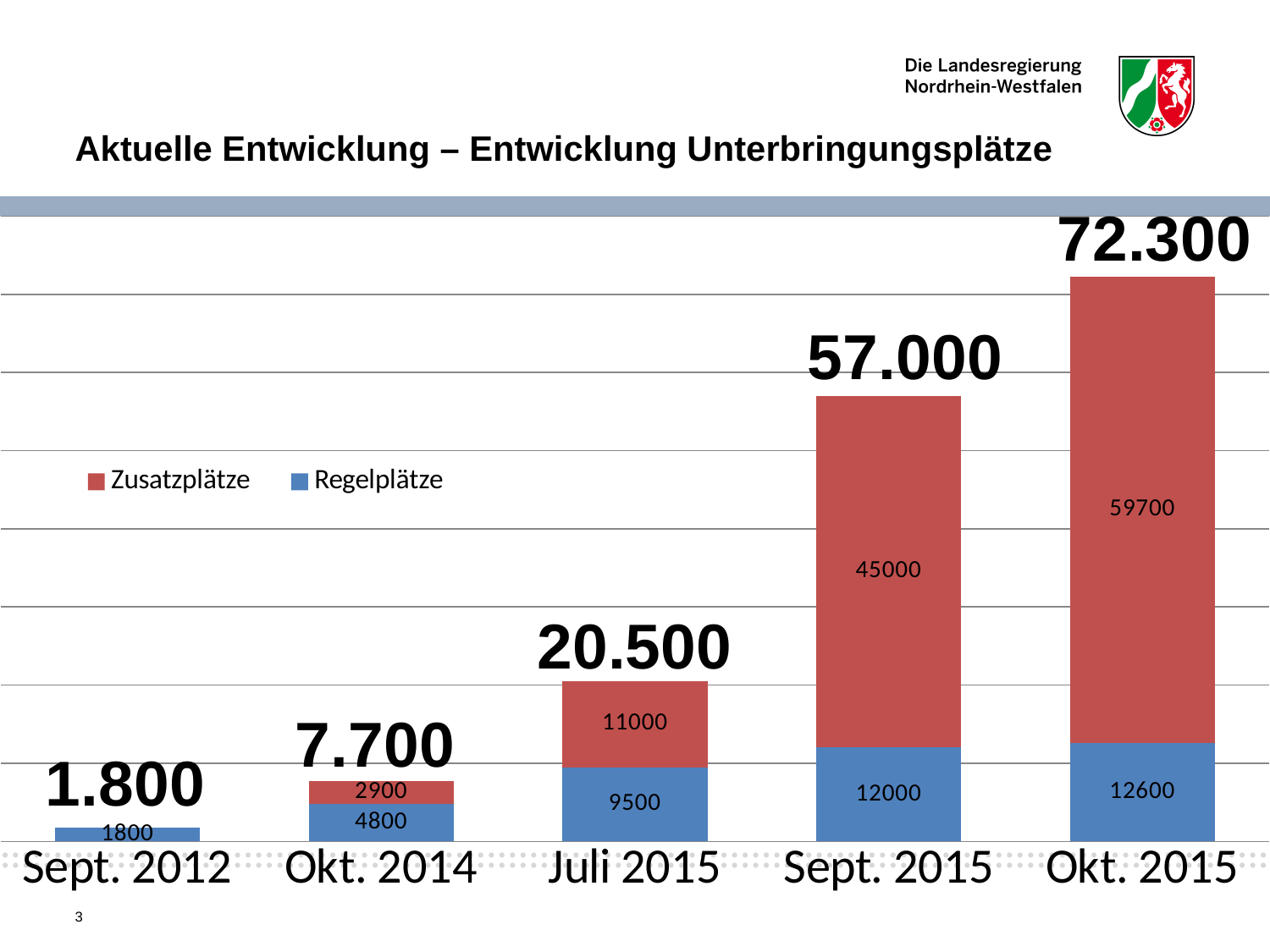
What is the value of Zusatzplätze for Sept. 2015? 45000 What is the value of Regelplätze for Okt. 2015? 12600 What is the value of Regelplätze for Juli 2015? 9500 Which category has the lowest total? Sept. 2012 What is the value of Zusatzplätze for Okt. 2014? 2900 Which is larger, the Regelplätze value for Sept. 2015 or the Zusatzplätze value for Juli 2015? Regelplätze for Sept. 2015 Which category has the highest total? Okt. 2015 How many series does the legend list? 2 What is the difference between the Zusatzplätze values for Okt. 2015 and Sept. 2015? 14700 What is the total shown above the bar for Juli 2015? 20.500 How many categories are shown on the x axis? 5 What is the total shown above the bar for Okt. 2015? 72.300